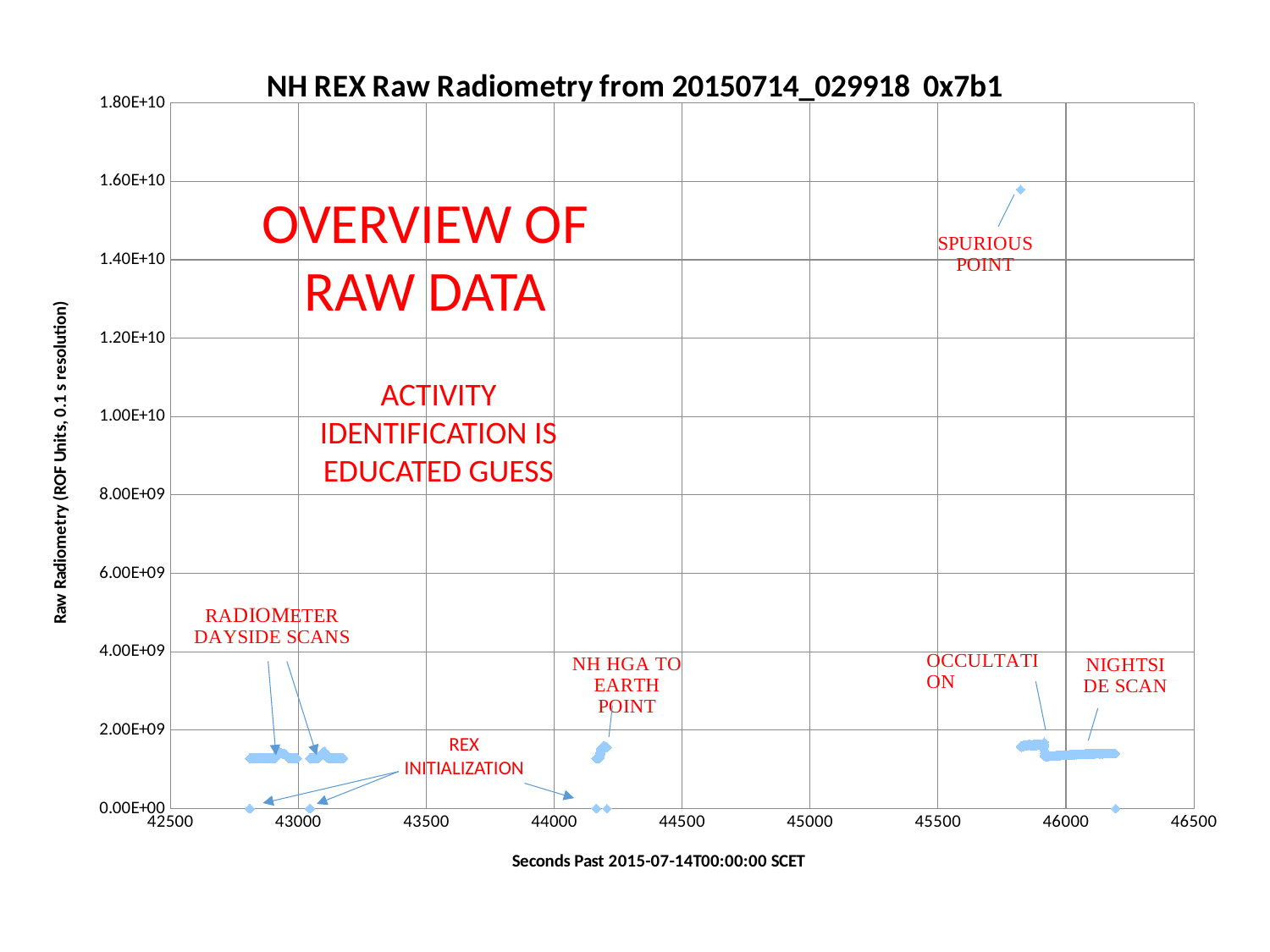
Are the values of the NIGHTSIDE SCAN greater or less than 2.00E+09? less What is the label of the x axis? Seconds Past 2015-07-14T00:00:00 SCET Which annotated feature has the highest raw radiometry value? SPURIOUS POINT Are the REX INITIALIZATION points greater or less than 2.00E+09? less What is the title of the chart? NH REX Raw Radiometry from 20150714_029918 0x7b1 What kind of chart is shown on the slide? Scatter chart Are the values of the OCCULTATION points greater or less than 4.00E+09? less Is the SPURIOUS POINT higher or lower than the NH HGA TO EARTH POINT? higher